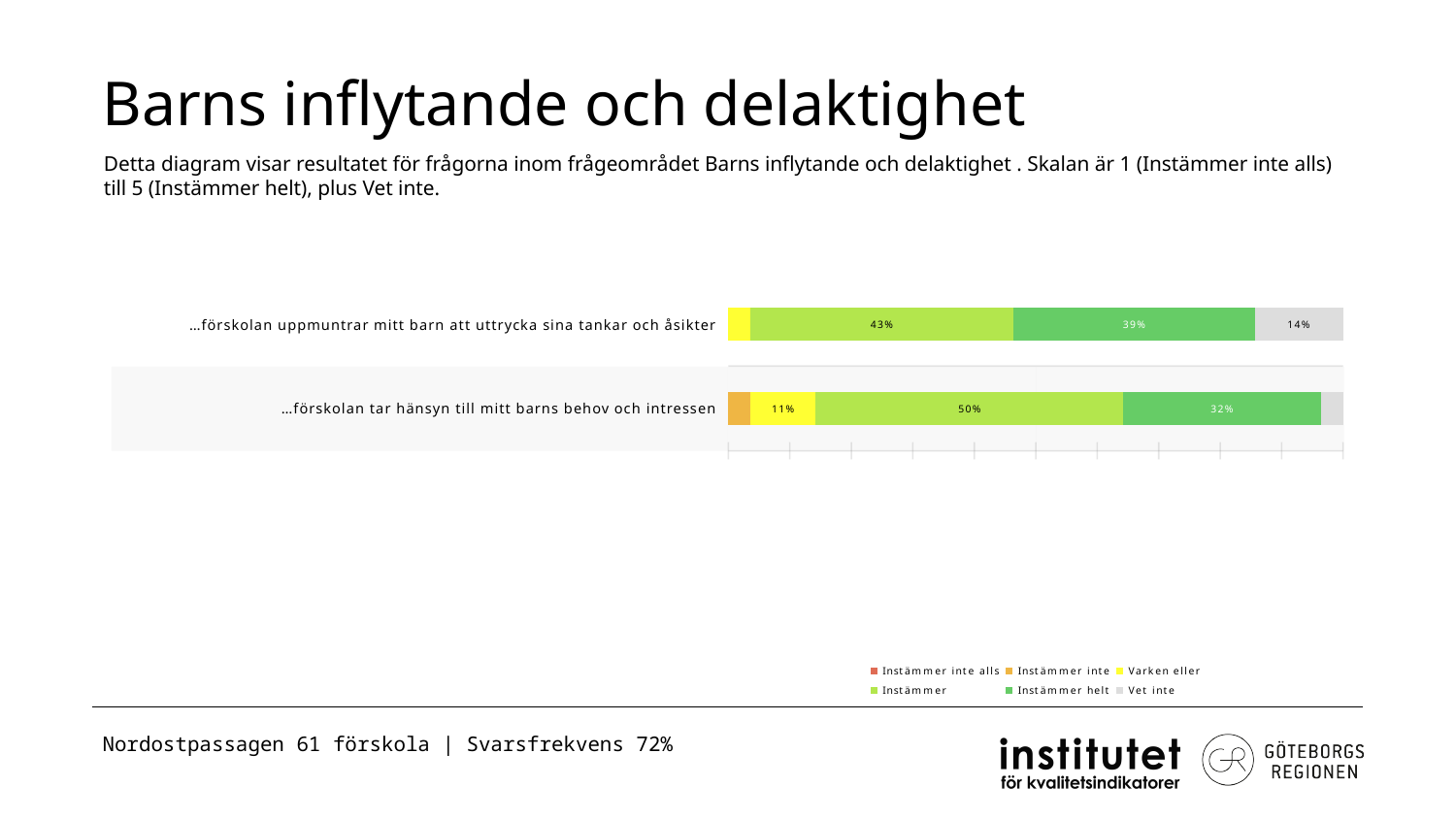
What kind of chart is shown on the slide? stacked bar chart What is the 'Varken eller' share for '…förskolan tar hänsyn till mitt barns behov och intressen'? 11% How many series does the legend list? 6 What is the difference between the 'Instämmer' shares of the two categories? 7% How many categories (questions) are plotted in the chart? 2 Which category has the larger 'Instämmer' share? …förskolan tar hänsyn till mitt barns behov och intressen Which legend entry is shown in grey? Vet inte What is the 'Vet inte' share for '…förskolan uppmuntrar mitt barn att uttrycka sina tankar och åsikter'? 14% What is the 'Instämmer helt' share for '…förskolan uppmuntrar mitt barn att uttrycka sina tankar och åsikter'? 39% What is the 'Instämmer' share for '…förskolan tar hänsyn till mitt barns behov och intressen'? 50% What is the 'Instämmer' share for '…förskolan uppmuntrar mitt barn att uttrycka sina tankar och åsikter'? 43% What is the 'Instämmer helt' share for '…förskolan tar hänsyn till mitt barns behov och intressen'? 32%